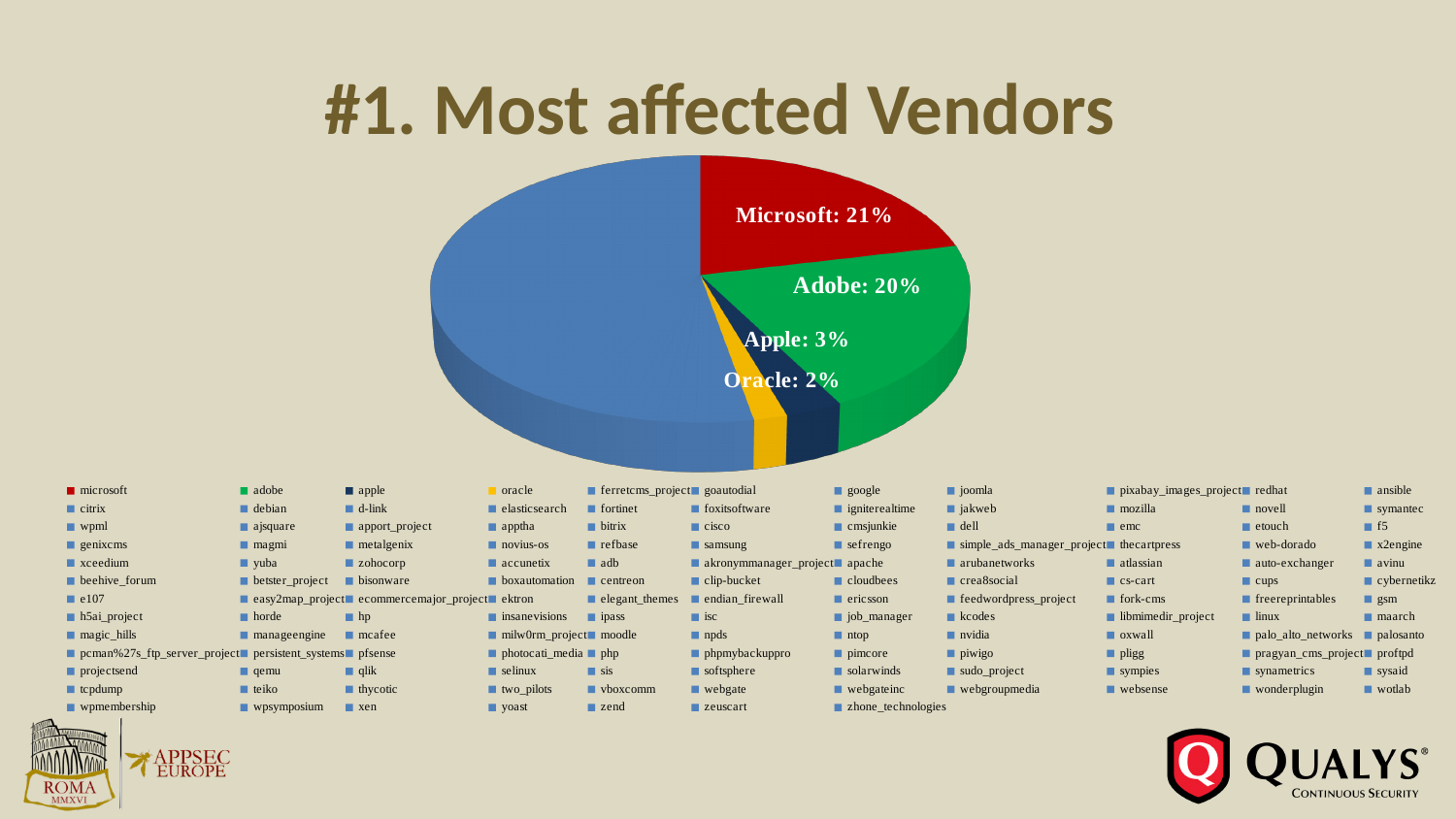
Which has a larger share, Apple or Oracle? Apple What is the title of the slide containing the chart? #1. Most affected Vendors Among the labeled slices, which vendor has the smallest share? Oracle What is the difference in percentage points between Adobe's and Apple's shares? 17% What kind of chart is shown on the slide? Pie chart What is the difference in percentage points between Microsoft's and Adobe's shares? 1% What percentage is shown for Apple in the pie chart? 3% What percentage is shown for Microsoft in the pie chart? 21% Which has a larger share, Microsoft or Adobe? Microsoft Among the labeled slices, which vendor has the largest share? Microsoft What percentage is shown for Oracle in the pie chart? 2% What percentage is shown for Adobe in the pie chart? 20%